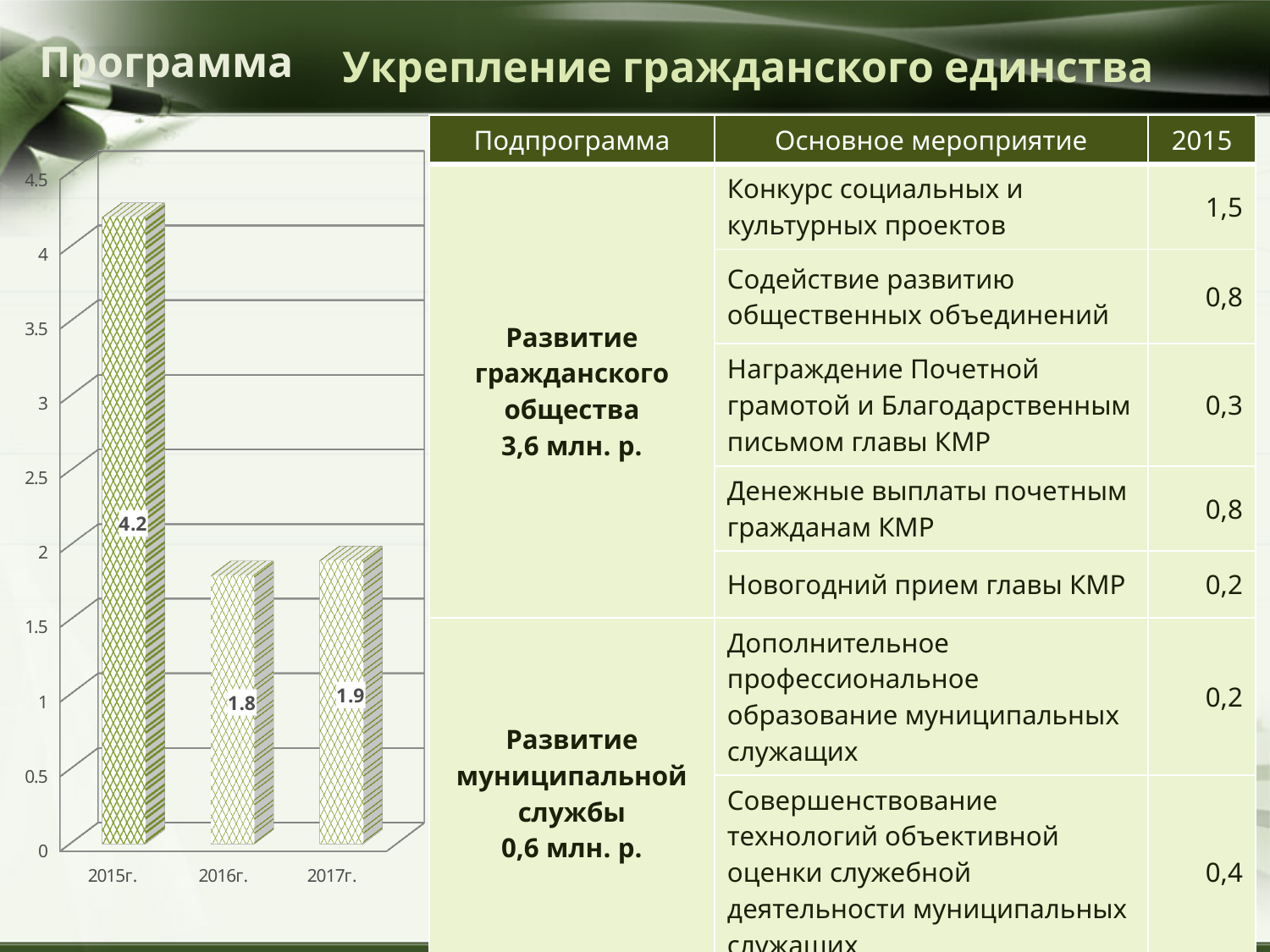
What kind of chart is shown on the slide? bar chart What is the value for 2017г.? 1.9 Which is larger, the value for 2015г. or the value for 2017г.? 2015г. Is the value for 2015г. greater or less than 4? greater What is the difference between the values for 2017г. and 2016г.? 0.1 Which year has the lowest value? 2016г. What is the difference between the values for 2015г. and 2016г.? 2.4 What is the value for 2016г.? 1.8 Is the value for 2016г. greater or less than 2? less What is the value for 2015г.? 4.2 How many categories are shown on the x axis of the chart? 3 Which year has the highest value? 2015г.